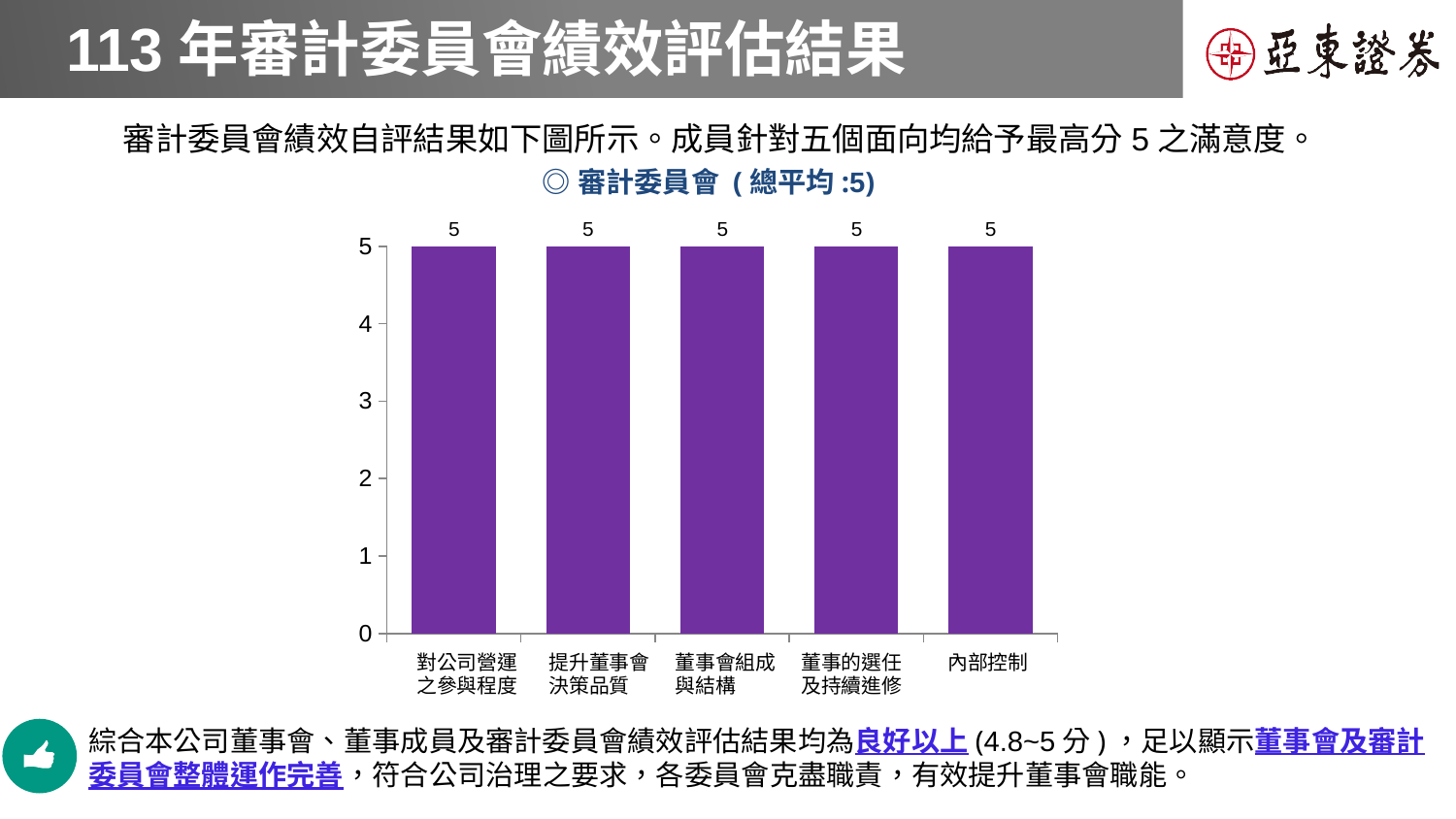
What is the title of the chart? 審計委員會（總平均:5） Do the values rise, fall, or stay flat across the categories from left to right? Stay flat Is the value for 董事會組成與結構 greater or less than 4? greater What is the value for 董事會組成與結構? 5 What is the value for 董事的選任及持續進修? 5 What is the value for 提升董事會決策品質? 5 What kind of chart is shown on the slide? Bar chart How many categories are shown on the x axis of the chart? 5 What colour are the bars in the chart? Purple What is the value for 對公司營運之參與程度? 5 What is the difference between the values for 內部控制 and 提升董事會決策品質? 0 What is the value for 內部控制? 5